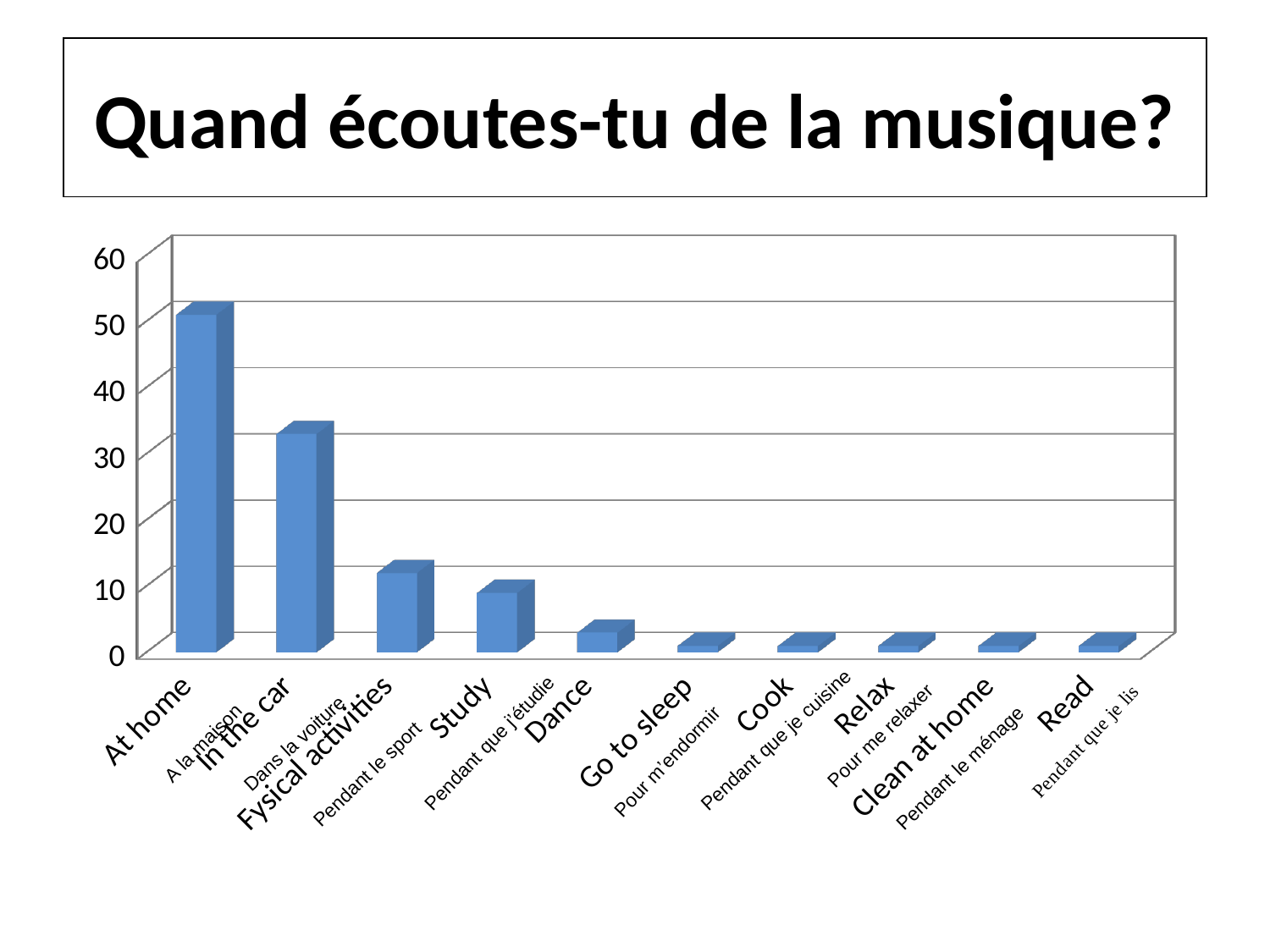
Is the value for At home greater or less than 40? greater Is the value for Fysical activities greater or less than 20? less How many categories are shown on the x axis? 10 Do the values rise or fall from left to right along the x axis? fall Which category has the highest value? At home What kind of chart is shown on the slide? bar chart What is the title of the slide above the chart? Quand écoutes-tu de la musique? Is the value for In the car greater or less than 20? greater Which is larger, the value for In the car or the value for Study? In the car